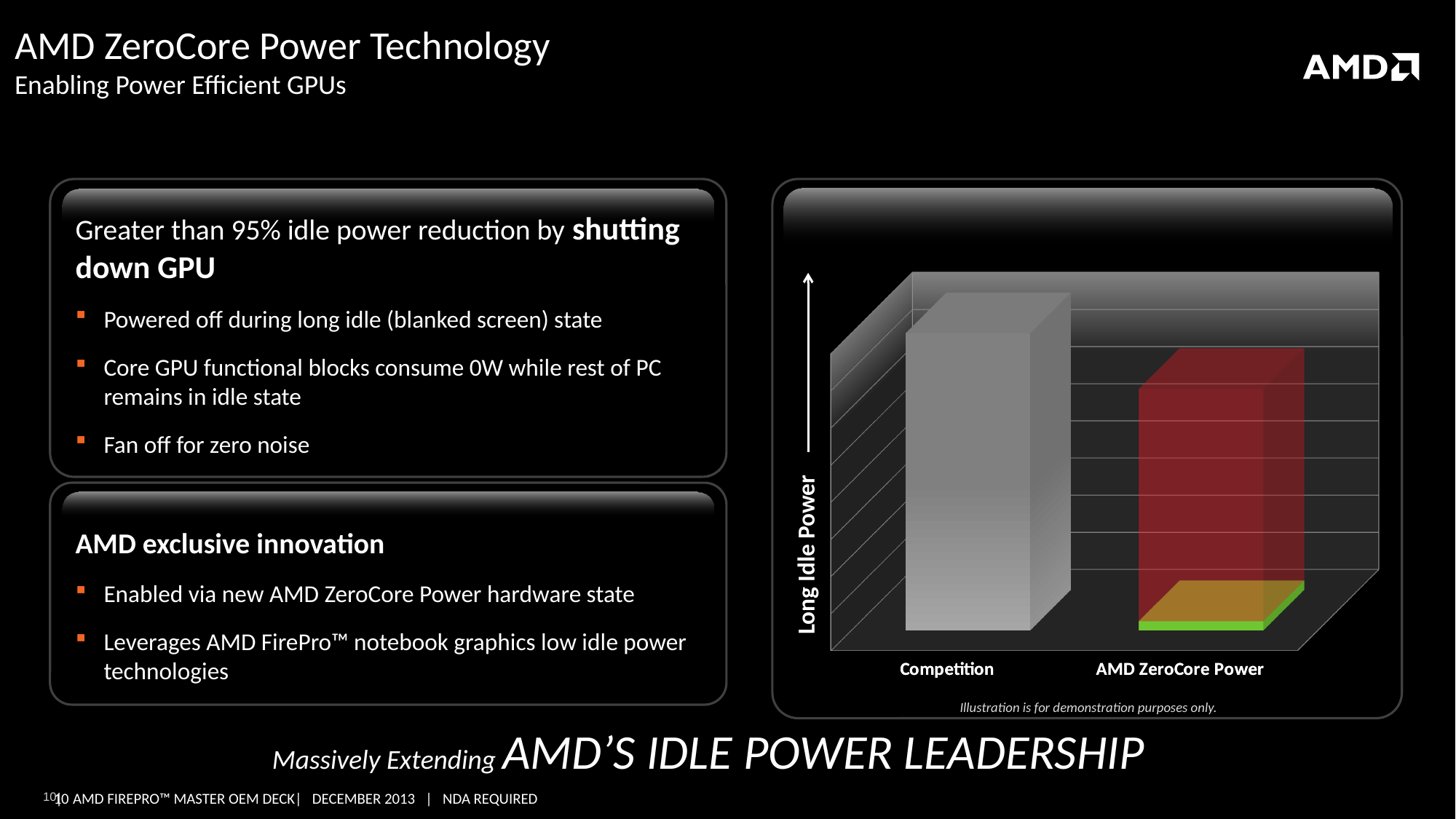
What are the two categories labelled on the x axis of the chart? Competition and AMD ZeroCore Power Which category has the tallest bar in the chart? Competition Does the long idle power rise or fall from Competition to AMD ZeroCore Power along the x axis? fall How many categories are shown on the x axis of the chart? 2 What is the label on the vertical axis of the chart? Long Idle Power Which category has the lowest long idle power in the chart? AMD ZeroCore Power Which has the higher long idle power in the chart, Competition or AMD ZeroCore Power? Competition What kind of chart is shown on the right side of the slide? bar chart